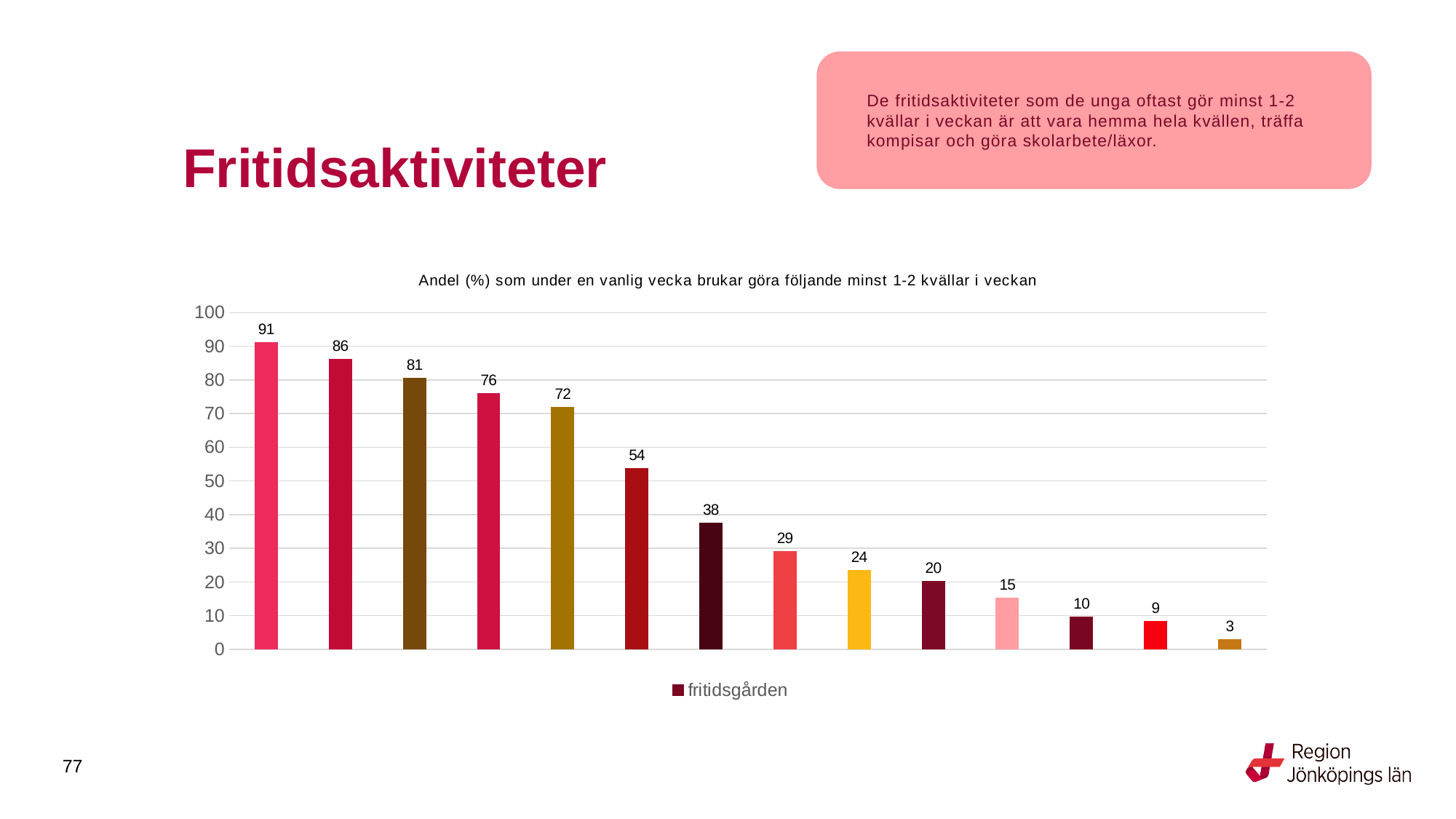
What is the value of the third bar from the left? 81 What is the value of the rightmost (last) bar in the chart? 3 What kind of chart is shown on the slide? bar chart How many series does the legend list? 1 How many bars are plotted in the chart? 14 What entry is shown in the chart legend? fritidsgården What is the value of the leftmost (first) bar in the chart? 91 What is the title of the chart? Andel (%) som under en vanlig vecka brukar göra följande minst 1-2 kvällar i veckan Do the bar values rise or fall from left to right along the x axis? fall What is the difference between the first bar (91) and the second bar (86)? 5 What is the lowest value shown in the chart? 3 What is the highest value shown in the chart? 91